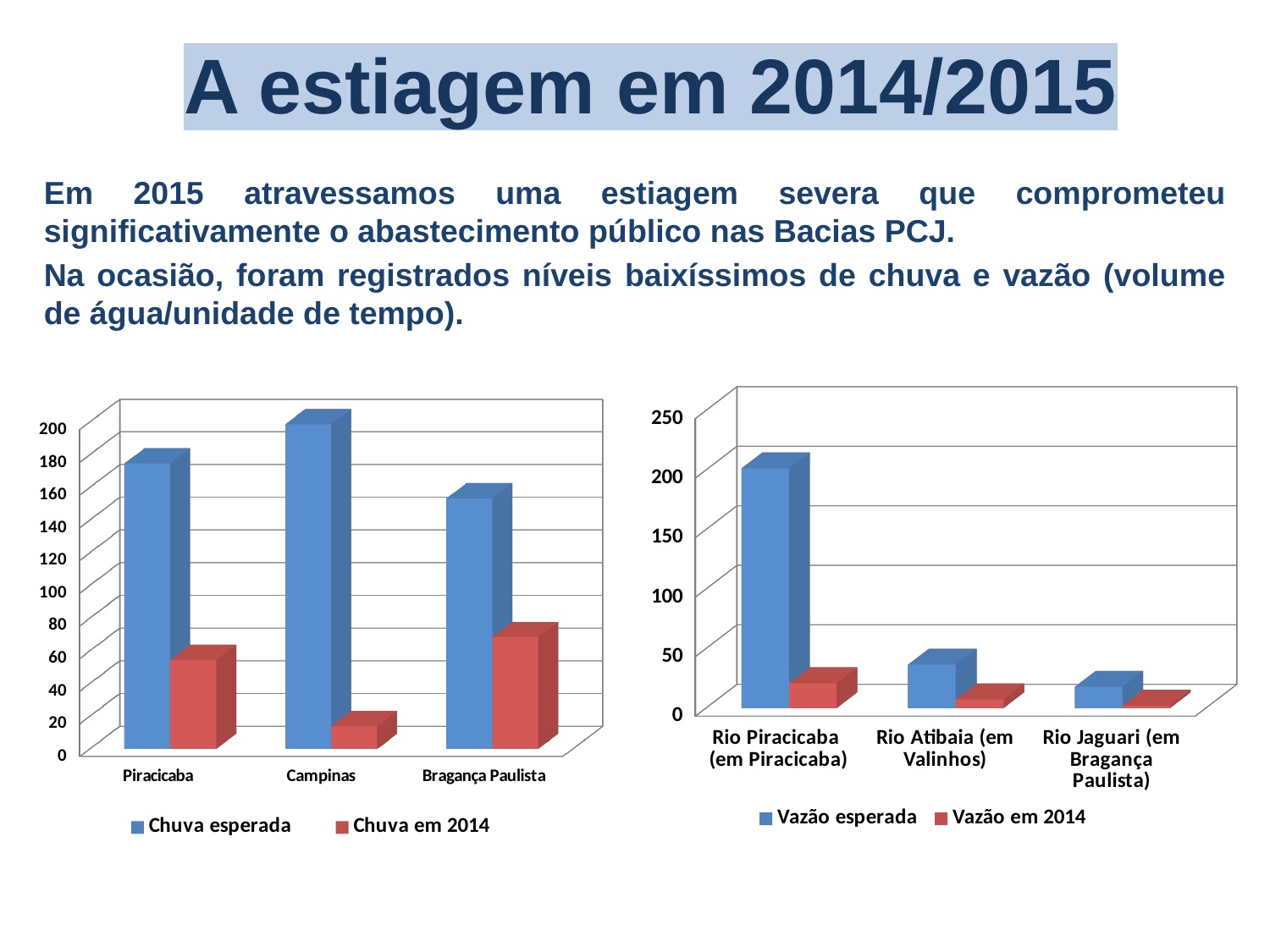
How many categories are shown on the right chart (Vazão esperada / Vazão em 2014)? 3 On the left chart, which is larger: Chuva em 2014 for Piracicaba or Chuva em 2014 for Bragança Paulista? Bragança Paulista What are the two legend entries of the right chart? Vazão esperada and Vazão em 2014 How many categories are shown on the left chart (Chuva esperada / Chuva em 2014)? 3 On the right chart, is the Vazão esperada value for Rio Piracicaba (em Piracicaba) greater or less than 150? greater On the right chart, which category has the highest Vazão esperada value? Rio Piracicaba (em Piracicaba) On the left chart, which category has the highest Chuva esperada value? Campinas On the left chart, which category has the lowest Chuva em 2014 value? Campinas What kind of chart is the left chart (Chuva esperada / Chuva em 2014)? bar chart On the left chart, is the Chuva em 2014 value for Campinas greater or less than 40? less On the left chart, is the Chuva esperada value for Campinas greater or less than 180? greater How many series does the legend of the left chart (Chuva esperada / Chuva em 2014) list? 2